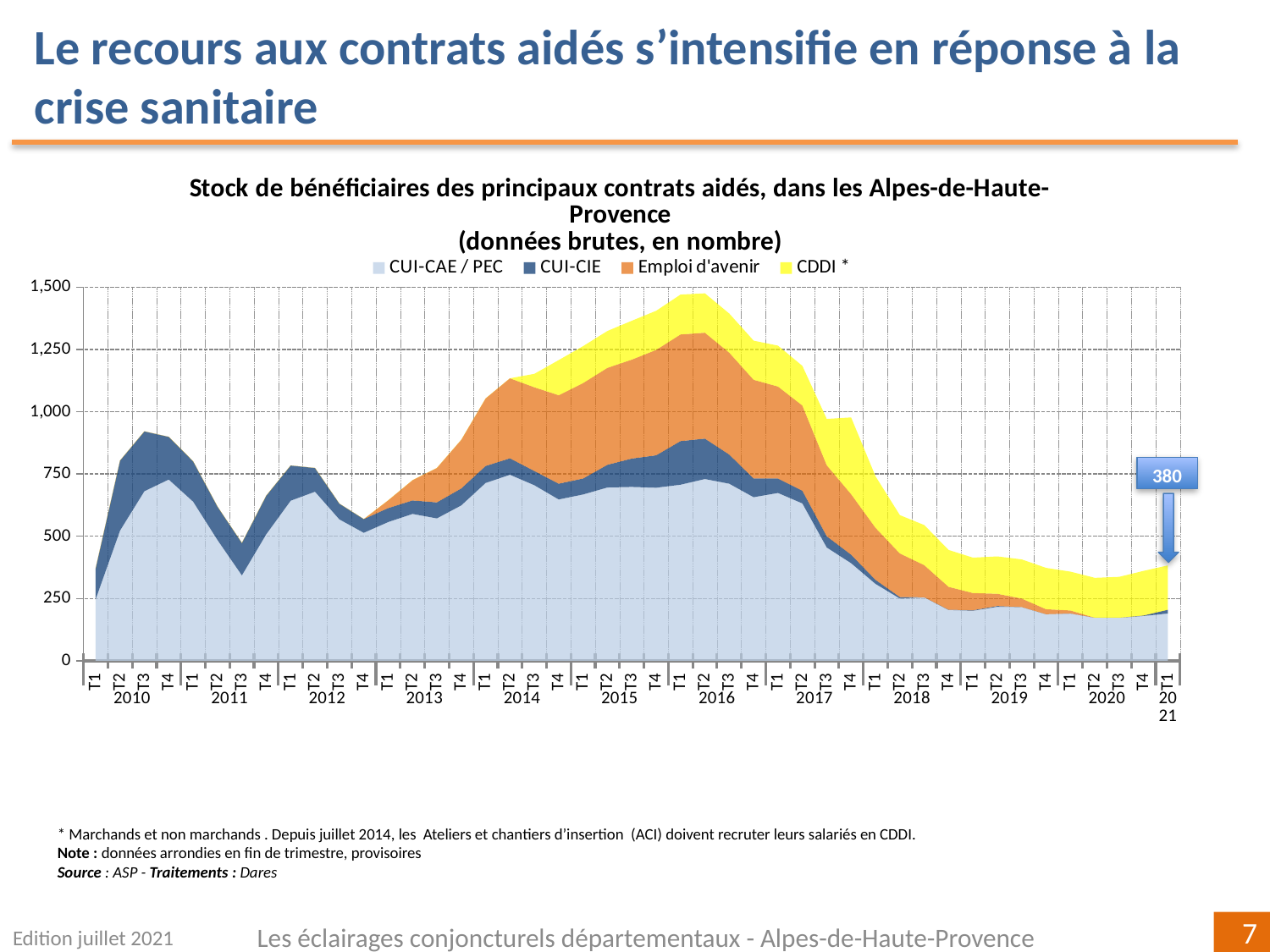
Is the total stock of beneficiaries at T1 2021 greater or less than 500? less What value is labelled for the total stock at T1 2021? 380 Which series forms the bottom layer of the stacked area? CUI-CAE / PEC Between T2 2016 and T1 2021, does the total stock of beneficiaries rise or fall? Fall How many series does the legend list? 4 Is the total stock of beneficiaries at its peak in 2016 greater or less than 1,250? greater What kind of chart is shown on the slide? Stacked area chart Which series is shown in yellow? CDDI * In which year does the total stock of beneficiaries reach its highest level? 2016 Is the total stock of beneficiaries at T3 2011 greater or less than 500? less Is the total stock of beneficiaries larger in 2016 or in 2020? 2016 How many years are labelled on the x axis? 12